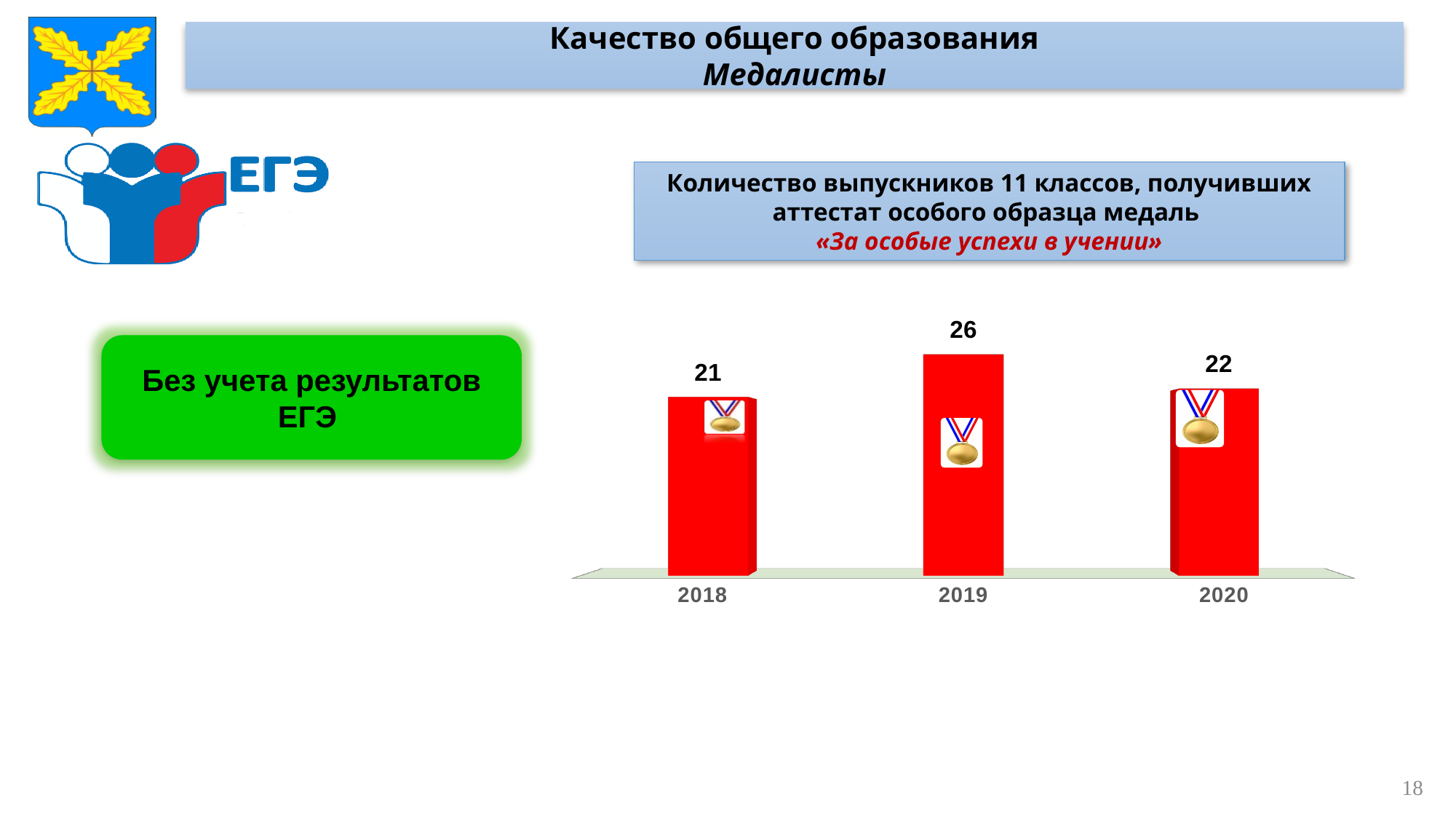
Which is larger, the value for 2020 or the value for 2018? 2020 What is the difference between the values for 2019 and 2020? 4 How many years are shown on the chart? 3 Which year has the lowest value? 2018 Which year has the highest value? 2019 What kind of chart is shown on the slide? bar chart What is the difference between the values for 2019 and 2018? 5 Does the value rise or fall from 2018 to 2019? rise What colour are the bars in the chart? red What is the value for 2018? 21 What is the value for 2019? 26 What is the value for 2020? 22